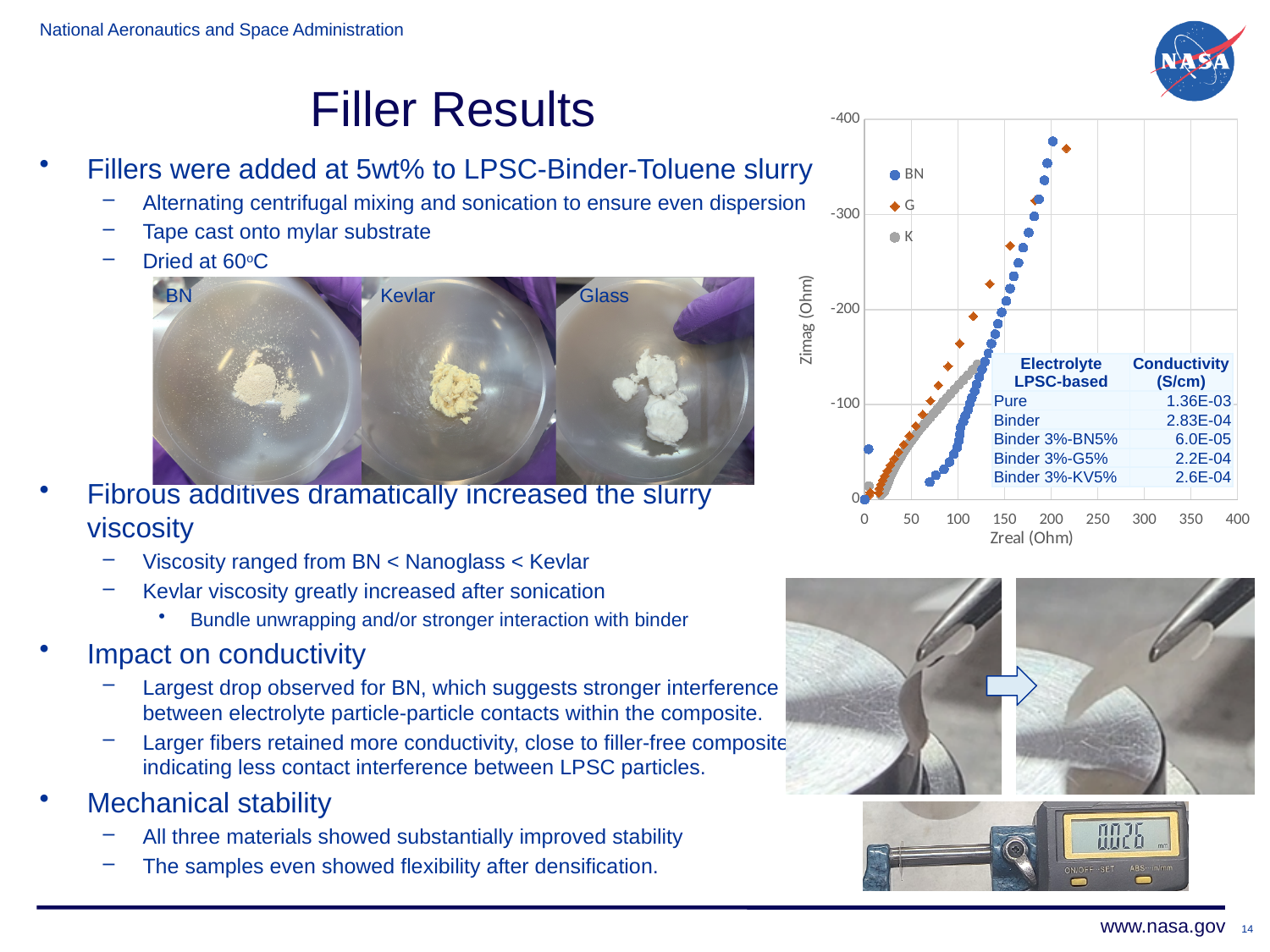
Is the largest Zreal value reached by the BN series greater or less than 150? greater In the conductivity table on the chart, which filler composite has the lowest conductivity? Binder 3%-BN5% How many series does the chart's legend list? 3 In the conductivity table on the chart, what is the conductivity of Binder 3%-BN5%? 6.0E-05 What kind of chart is shown on the slide? scatter chart Is the largest Zreal value reached by the K series greater or less than 200? less In the conductivity table on the chart, what is the conductivity of the Pure LPSC-based electrolyte? 1.36E-03 What are the series names listed in the chart's legend? BN, G, K As Zreal increases along the x axis, does Zimag become more negative or less negative? more negative What is the label of the chart's x axis? Zreal (Ohm) Is the most negative Zimag value reached by the G series greater or less than -300 in magnitude (i.e., beyond -300)? greater